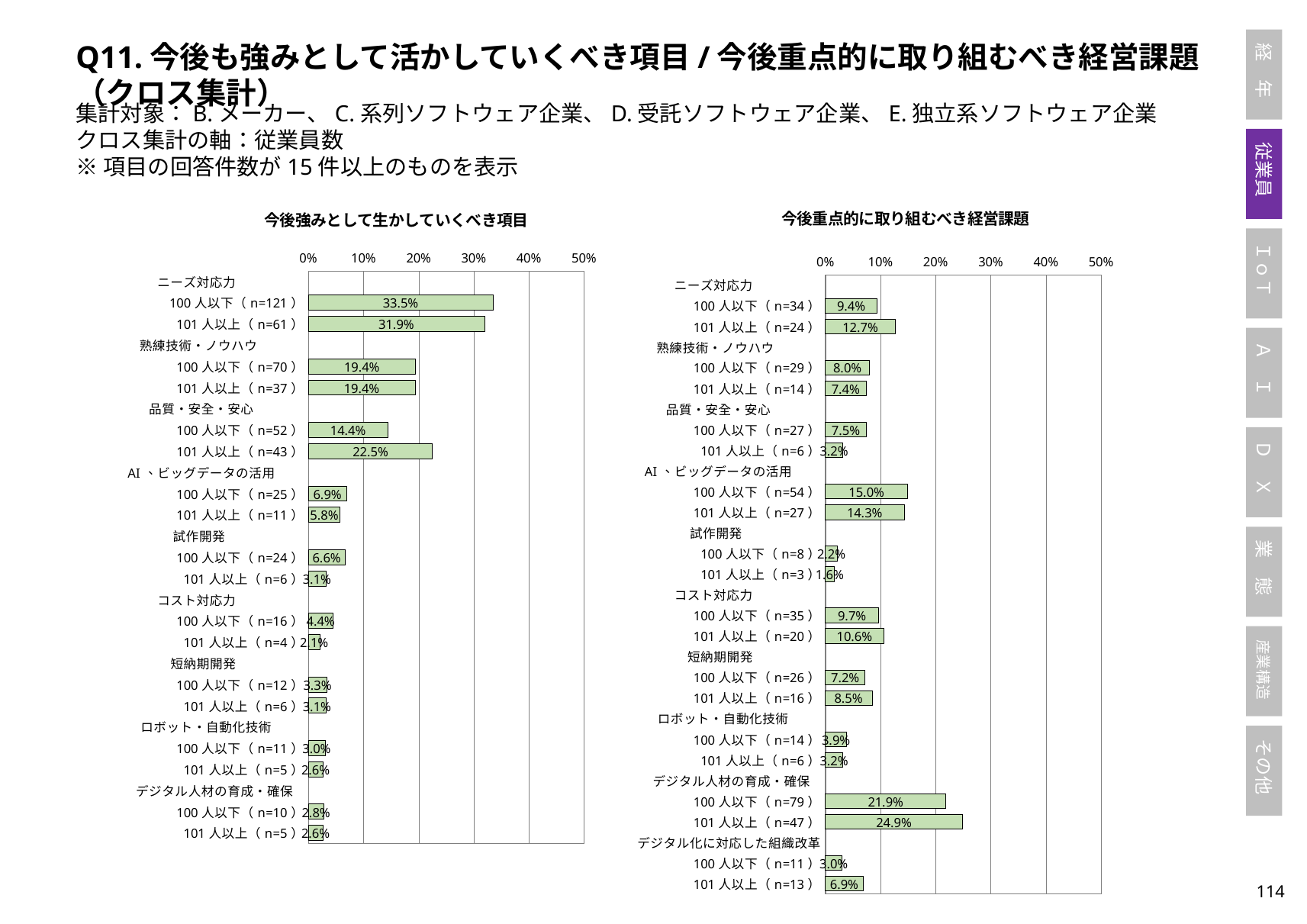
In the left chart (今後強みとして生かしていくべき項目), is the value for ニーズ対応力 100人以下 (n=121) greater or less than 30%? greater In the left chart (今後強みとして生かしていくべき項目), which bar has the highest value? ニーズ対応力 100人以下 (n=121) In the right chart (今後重点的に取り組むべき経営課題), what is the value for AI、ビッグデータの活用, 100人以下 (n=54)? 15.0% In the right chart (今後重点的に取り組むべき経営課題), what is the value for デジタル人材の育成・確保, 101人以上 (n=47)? 24.9% In the left chart (今後強みとして生かしていくべき項目), what is the value for ニーズ対応力, 100人以下 (n=121)? 33.5% How many item groups (categories) are shown in the right chart (今後重点的に取り組むべき経営課題)? 10 What kind of chart is the left chart (今後強みとして生かしていくべき項目)? Bar chart In the left chart (今後強みとして生かしていくべき項目), what is the difference between 品質・安全・安心 101人以上 (n=43) and 100人以下 (n=52)? 8.1% In the right chart (今後重点的に取り組むべき経営課題), which is larger: ニーズ対応力 100人以下 (n=34) or 101人以上 (n=24)? 101人以上 (n=24) In the right chart (今後重点的に取り組むべき経営課題), which bar has the lowest value? 試作開発 101人以上 (n=3) In the left chart (今後強みとして生かしていくべき項目), what is the value for 品質・安全・安心, 101人以上 (n=43)? 22.5% In the right chart (今後重点的に取り組むべき経営課題), what is the difference between デジタル化に対応した組織改革 101人以上 (n=13) and 100人以下 (n=11)? 3.9%